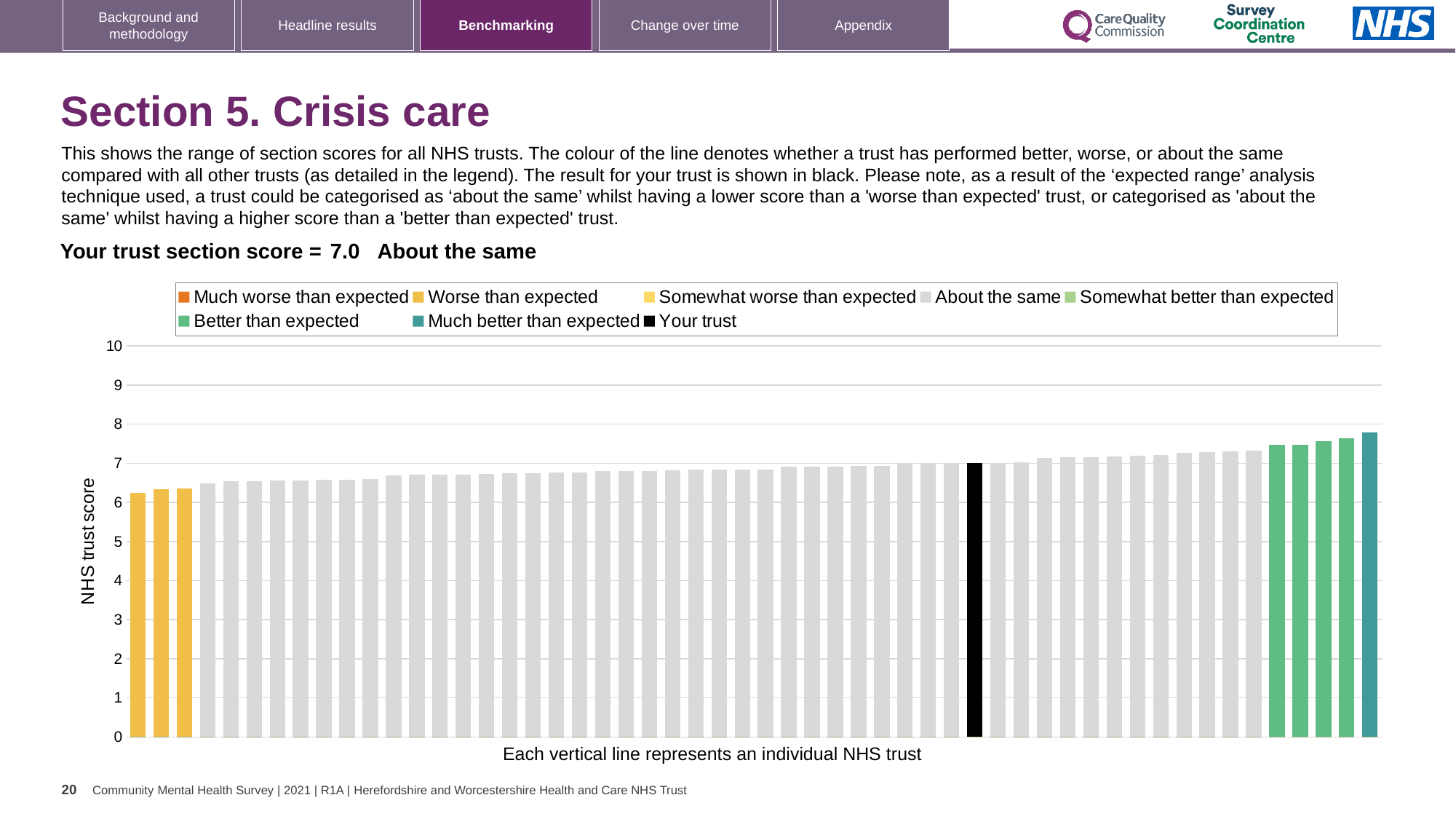
Do the bar values rise or fall from left to right across the chart? rise Is the value for the rightmost (highest) bar greater or less than 8? less What kind of chart is shown on the slide? bar chart How many bars are coloured as 'Worse than expected' (yellow)? 3 Which category is your trust placed in for Crisis care? About the same What is your trust's section score for Crisis care? 7.0 How many bars are coloured as 'Much better than expected' (teal)? 1 Is the value for the black 'Your trust' bar greater or less than 5? greater Is the value for the leftmost (lowest) bar greater or less than 7? less What is the label on the vertical axis of the chart? NHS trust score How many entries does the chart legend list? 8